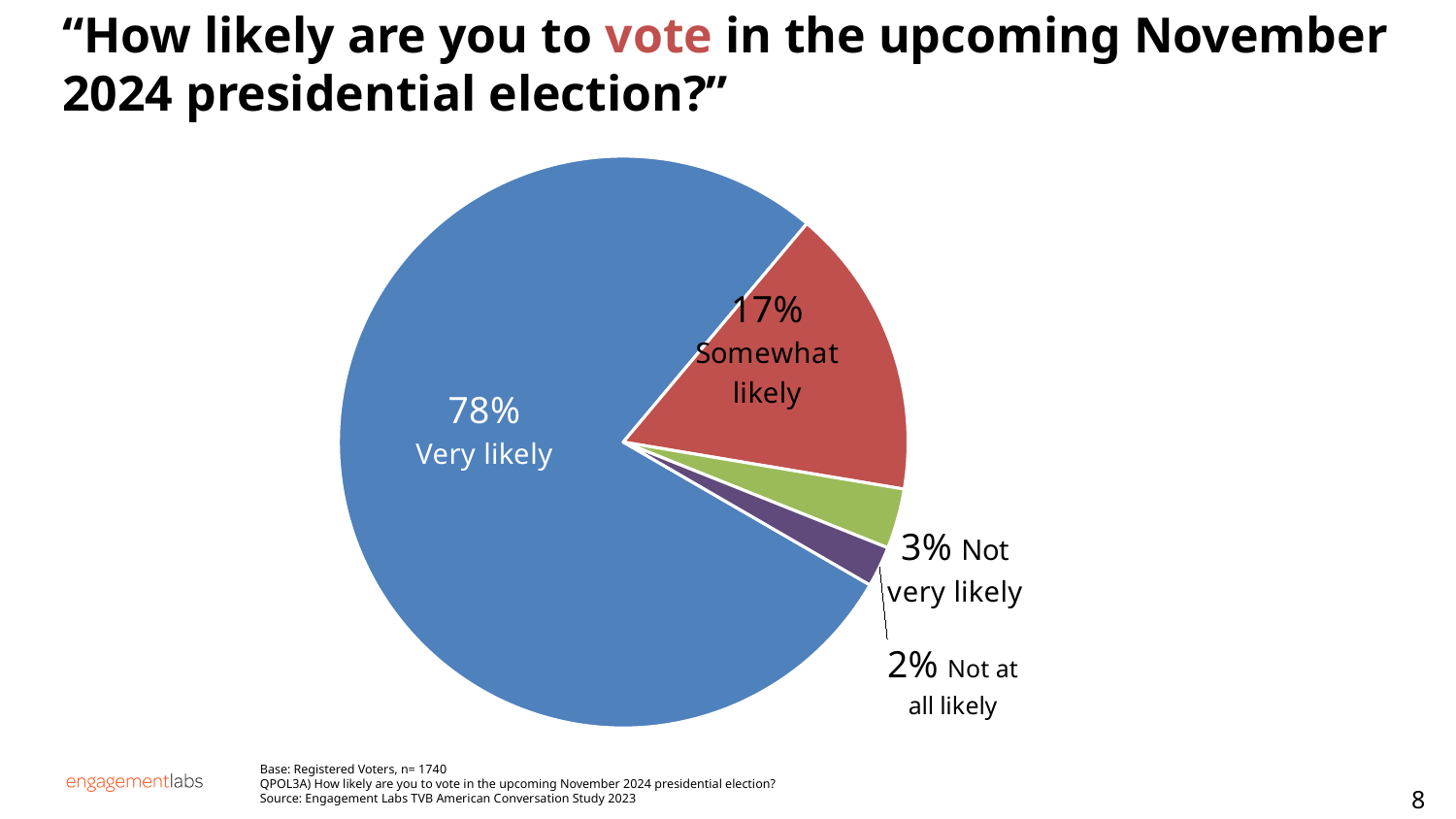
What kind of chart is shown on the slide? Pie chart What percentage of respondents said they are somewhat likely to vote? 17% What is the difference in percentage points between the Very likely and Somewhat likely slices? 61 What colour is the Very likely slice? Blue What is the combined percentage of respondents who are Very likely or Somewhat likely to vote? 95% How many slices does the pie chart have? 4 What percentage of respondents said they are very likely to vote? 78% Which is larger, the Not very likely slice or the Not at all likely slice? Not very likely What percentage of respondents said they are not very likely to vote? 3% Which response category has the smallest share of the pie? Not at all likely What percentage of respondents said they are not at all likely to vote? 2% Which response category has the largest share of the pie? Very likely